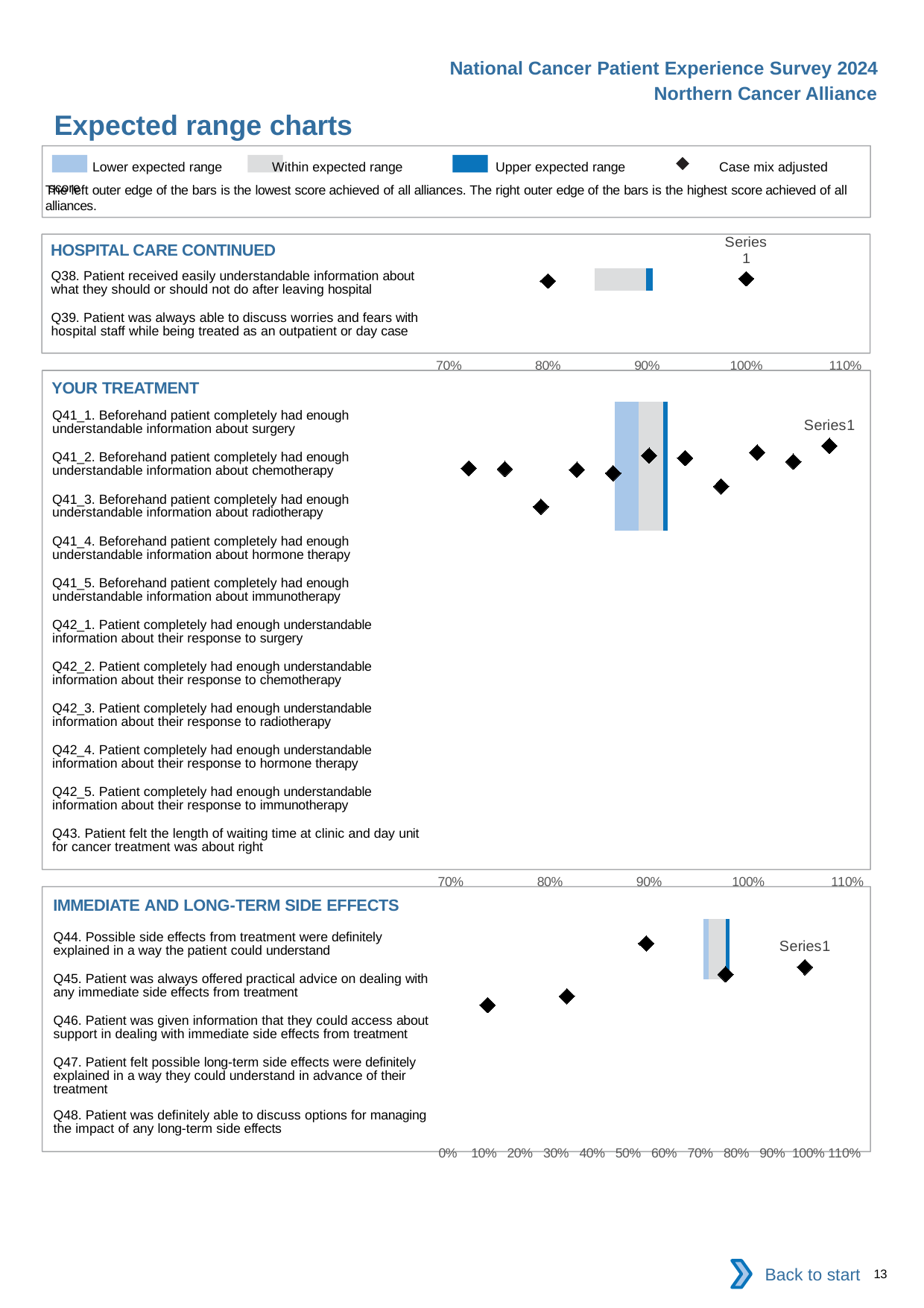
In the legend at the top of the slide, what does the diamond marker represent? Case mix adjusted score In the IMMEDIATE AND LONG-TERM SIDE EFFECTS chart, is the leftmost diamond marker greater or less than 20%? less How many entries does the legend at the top of the slide list? 4 In the HOSPITAL CARE CONTINUED chart, is the rightmost diamond marker greater or less than 90%? greater How many separate charts are shown on the slide? 3 In the IMMEDIATE AND LONG-TERM SIDE EFFECTS chart, is the rightmost diamond marker greater or less than 90%? greater What is the lowest tick label on the x axis of the IMMEDIATE AND LONG-TERM SIDE EFFECTS chart? 0% What is the title of the slide containing the charts? Expected range charts In the HOSPITAL CARE CONTINUED chart, how many diamond markers are plotted? 2 In the YOUR TREATMENT chart, how many diamond markers are plotted? 11